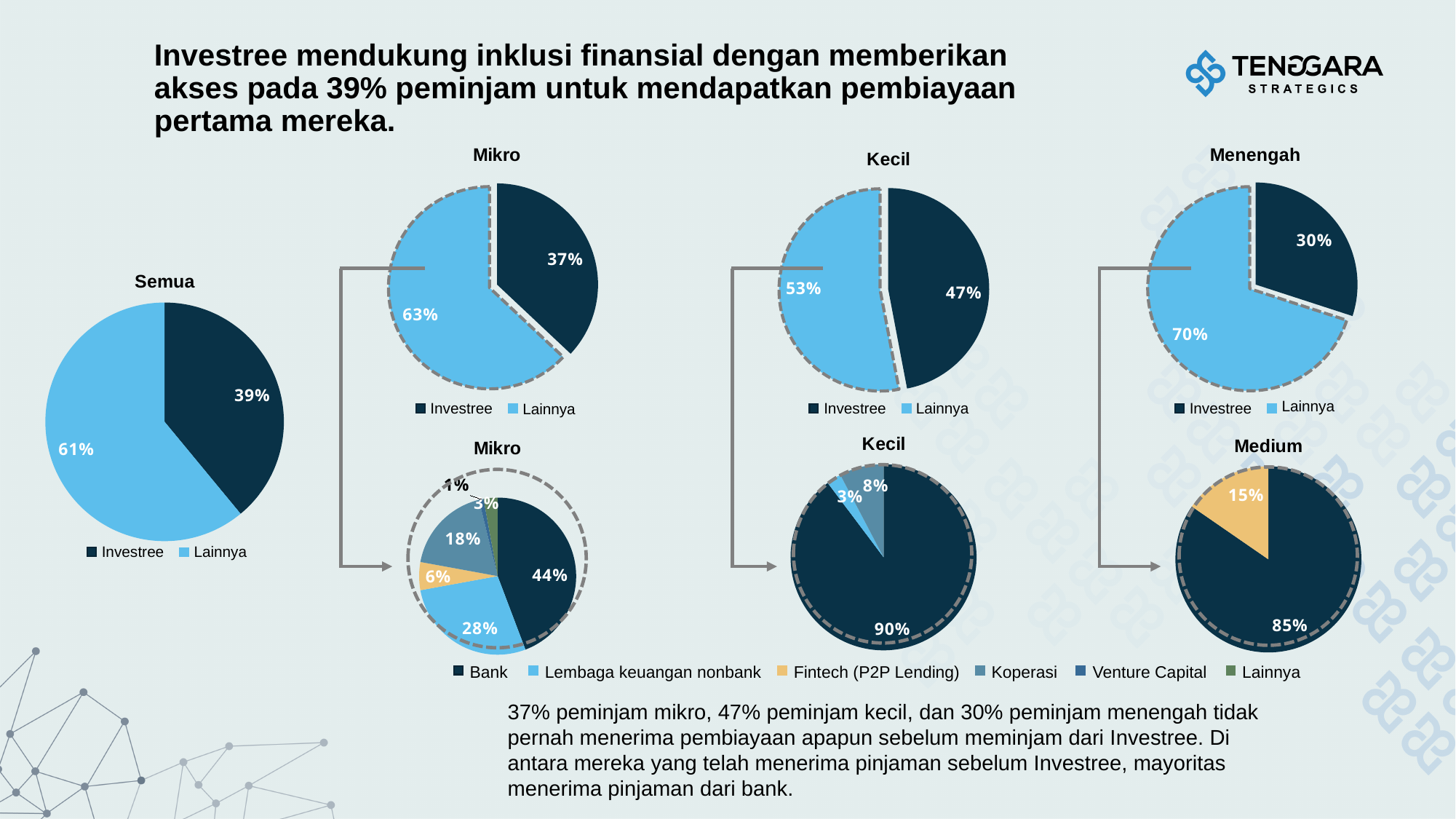
In the 'Medium' pie chart, what is the value for Fintech (P2P Lending)? 15% In the lower 'Kecil' pie chart, what is the value for Bank? 90% In the 'Menengah' pie chart, what is the difference between the Lainnya and Investree shares? 40% In the lower 'Mikro' pie chart, what is the value for Koperasi? 18% In the 'Semua' pie chart, what share is labelled for Lainnya? 61% In the upper 'Mikro' pie chart, what is the value for Investree? 37% In the lower 'Mikro' pie chart, which category has the largest share? Bank How many series does the shared legend below the lower row of pie charts list? 6 In the 'Semua' pie chart, what share is labelled for Investree? 39% In the upper 'Kecil' pie chart, what is the value for Lainnya? 53% In the lower 'Mikro' pie chart, what is the value for Bank? 44% In the 'Menengah' pie chart, what is the value for Investree? 30%